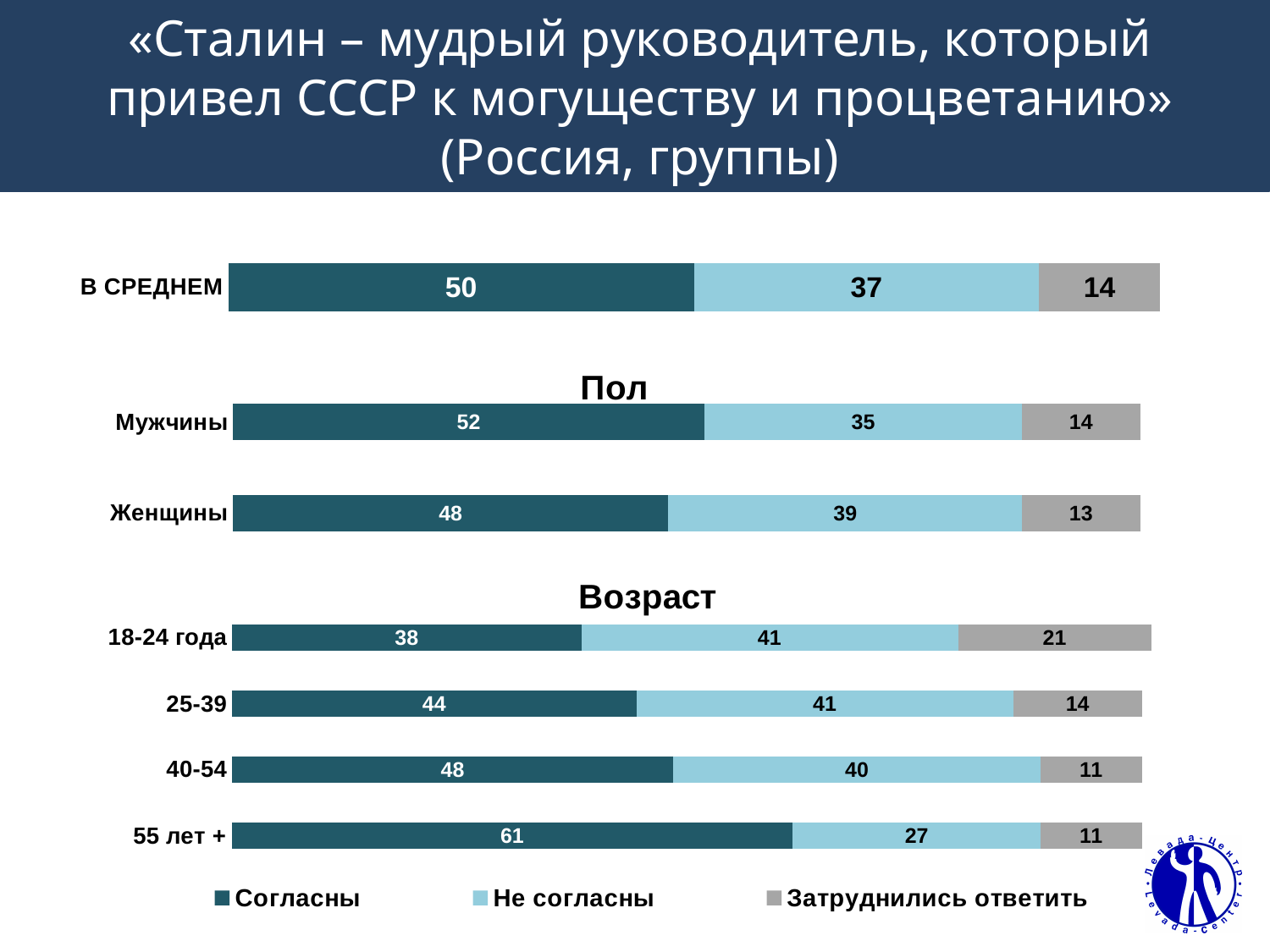
In the Пол chart, which group has the higher Согласны value, Мужчины or Женщины? Мужчины In the Возраст chart, how many age groups are shown? 4 In the Пол chart, what is the difference between the Согласны values for Мужчины and Женщины? 4 How many series does the legend at the bottom of the slide list? 3 In the Возраст chart, what is the total of the stacked bar for 55 лет +? 99 In the Пол chart, what is the Не согласны value for Женщины? 39 In the Возраст chart, what is the Затруднились ответить value for 18-24 года? 21 In the Возраст chart, which age group has the highest Согласны value? 55 лет + In the top chart (В СРЕДНЕМ), what is the value for Согласны? 50 In the top chart (В СРЕДНЕМ), what is the value for Затруднились ответить? 14 In the Возраст chart, which age group has the lowest Согласны value? 18-24 года What kind of chart is the Возраст chart? Stacked bar chart